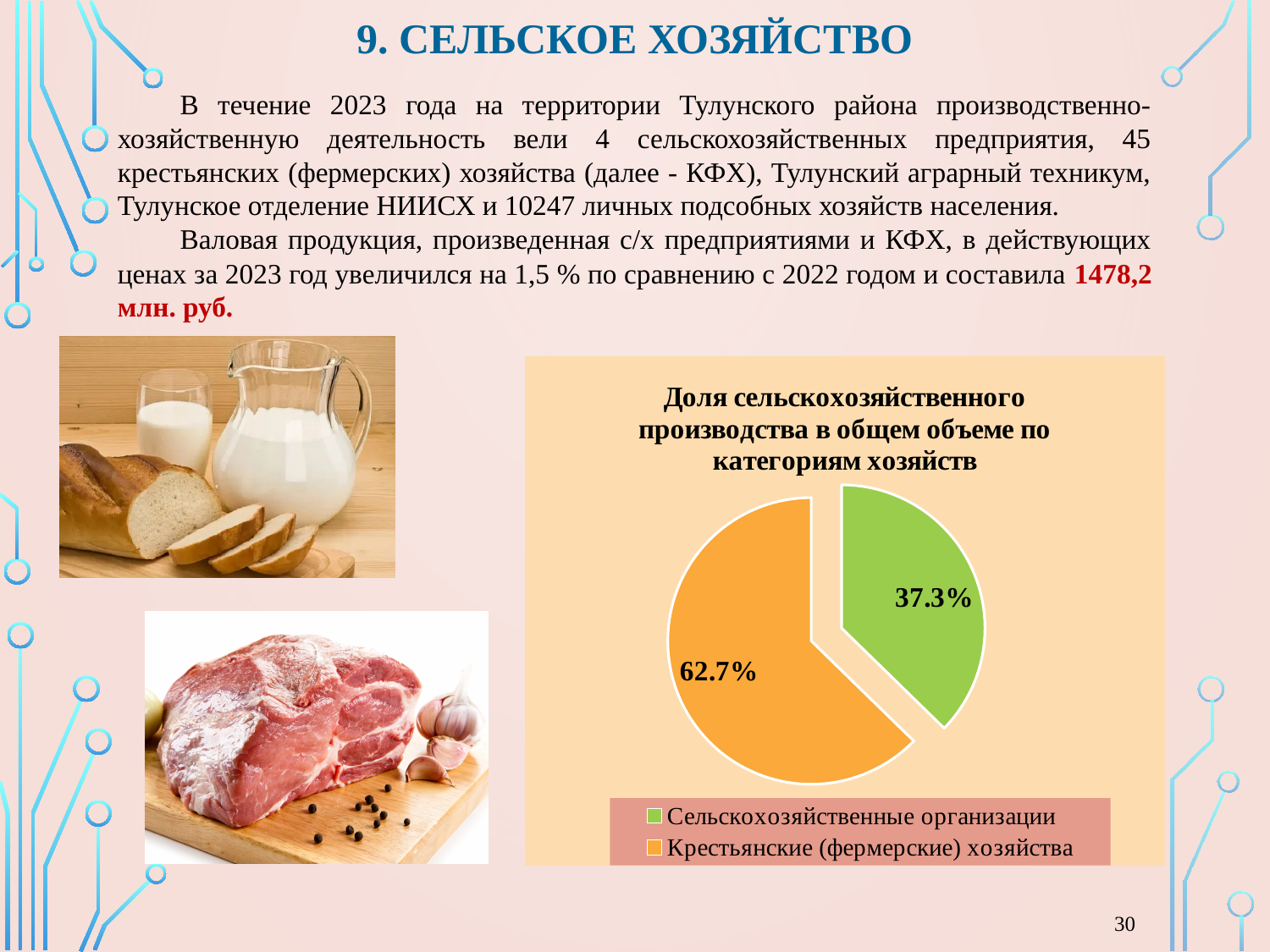
What kind of chart is shown on the slide? pie chart What is the difference in percentage points between the shares of Крестьянские (фермерские) хозяйства and Сельскохозяйственные организации? 25.4 What share of the pie is labelled for Крестьянские (фермерские) хозяйства? 62.7% Which category has the smallest share of the pie? Сельскохозяйственные организации Which is larger: the share of Сельскохозяйственные организации or the share of Крестьянские (фермерские) хозяйства? Крестьянские (фермерские) хозяйства How many slices does the pie chart have? 2 How many entries does the legend list? 2 Which category has the largest share of the pie? Крестьянские (фермерские) хозяйства What colour is the slice for Сельскохозяйственные организации? green What is the total of the two slice percentages shown on the pie chart? 100% What is the title of the chart? Доля сельскохозяйственного производства в общем объеме по категориям хозяйств What share of the pie is labelled for Сельскохозяйственные организации? 37.3%